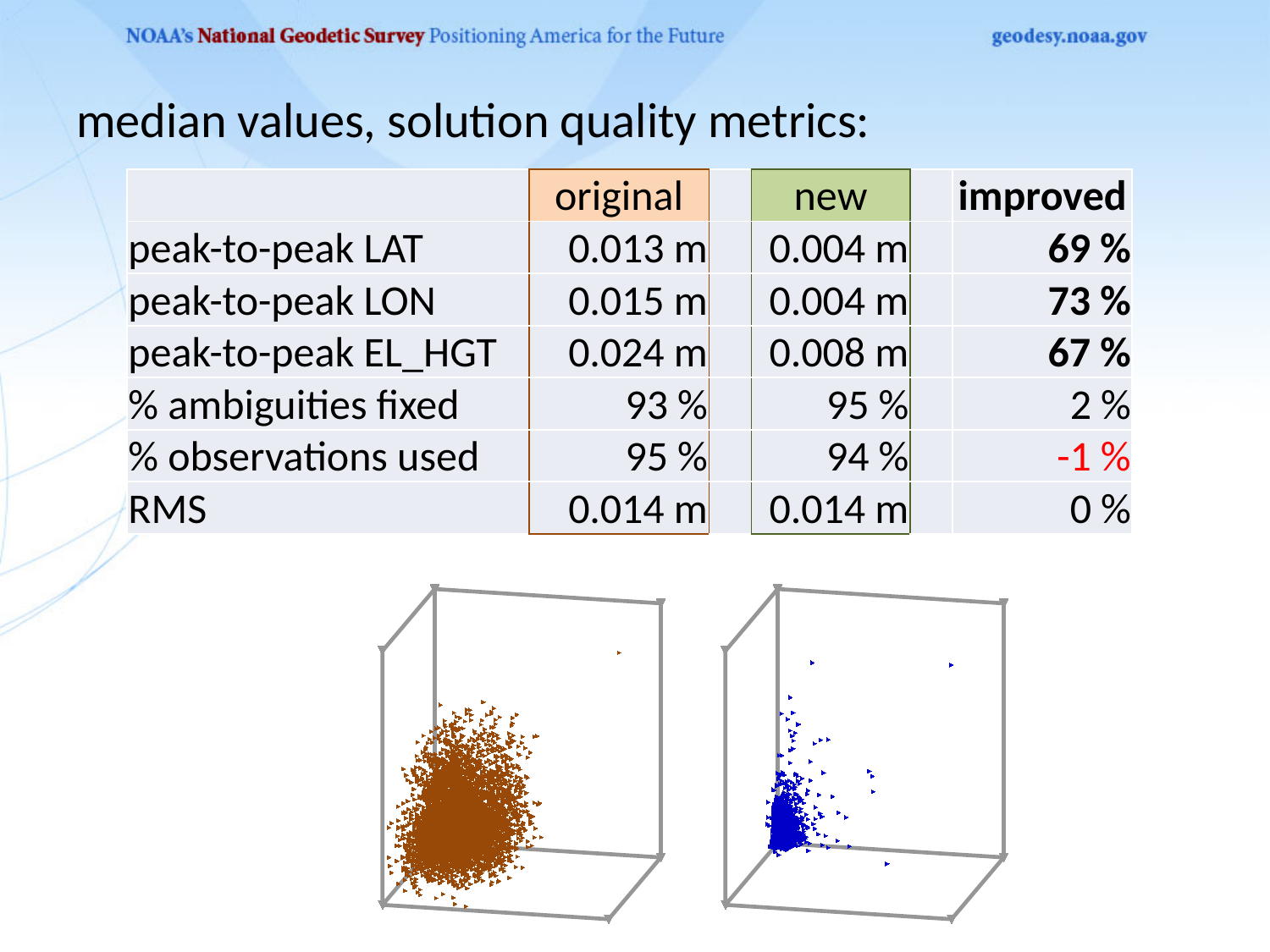
What colour are the points in the right scatter plot? Blue In the table, which metric has the lowest improvement percentage? % observations used In the table, what is the original peak-to-peak LAT value? 0.013 m In the table, what is the difference between the original and new peak-to-peak LON values? 0.011 m How many scatter plots are shown on the slide? 2 In the table, is the original RMS larger than the new RMS? No, they are equal (0.014 m) In the table, what is the new peak-to-peak EL_HGT value? 0.008 m In the table, what is the improvement for % ambiguities fixed? 2 % In the table, which metric has the highest improvement percentage? peak-to-peak LON What colour are the points in the left scatter plot? Brown/orange Which scatter plot shows the more tightly clustered points, the left or the right? The right What kind of charts are the two plots at the bottom of the slide? 3D scatter plots